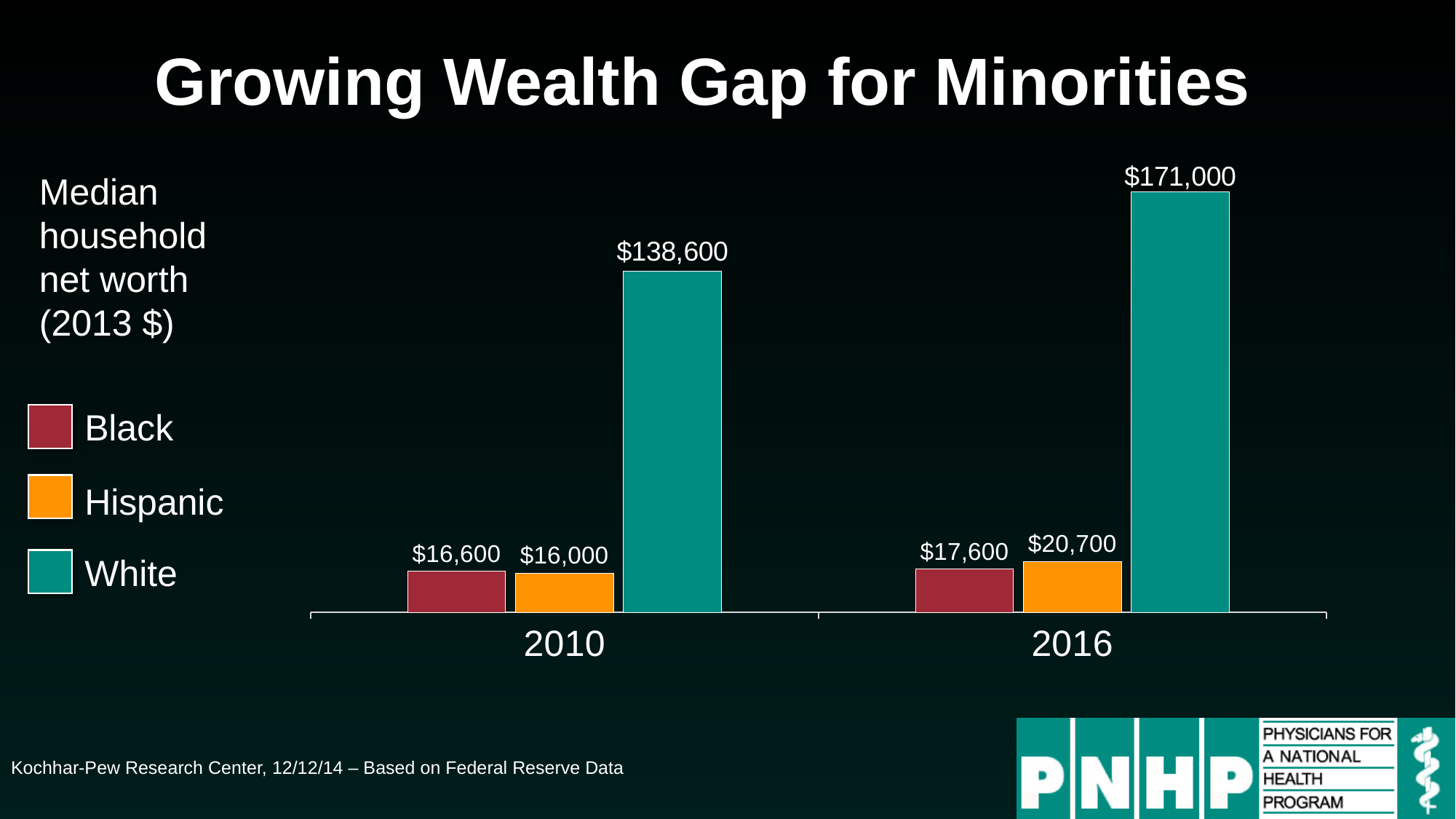
What is the median household net worth for White households in 2016? $171,000 What is the median household net worth for Black households in 2010? $16,600 What colour represents White households in the chart? Teal Which is larger in 2016, the Black or the Hispanic median household net worth? Hispanic Which group has the highest median household net worth in 2016? White What is the median household net worth for Hispanic households in 2016? $20,700 Which group has the lowest median household net worth in 2010? Hispanic By how much did the White median household net worth increase from 2010 to 2016? $32,400 How many series does the legend list? 3 What is the median household net worth for White households in 2010? $138,600 What is the difference between the White and Black median household net worth in 2016? $153,400 What kind of chart is shown on the slide? Bar chart